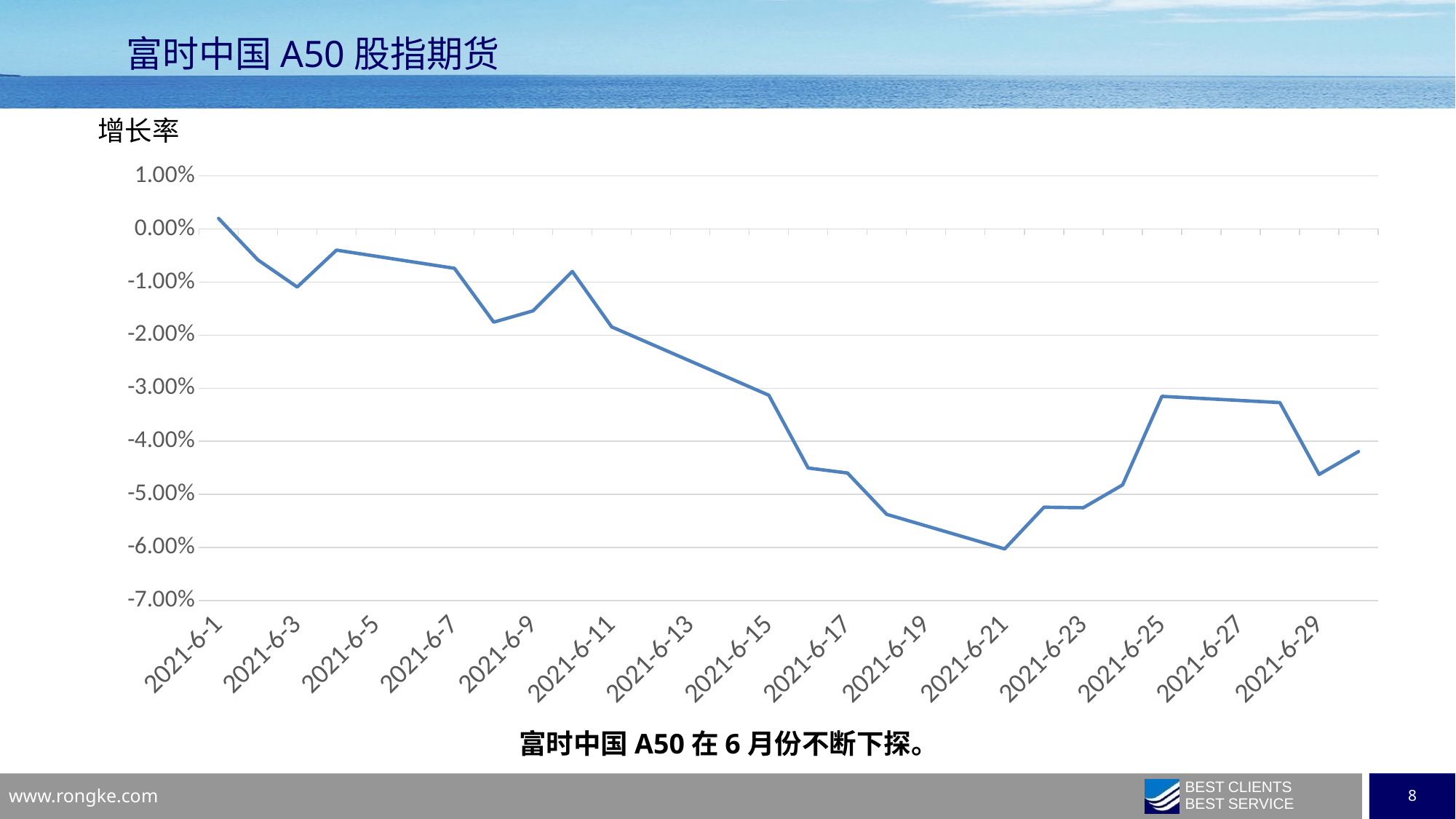
Is the value for 2021-6-21 greater or less than -5.00%? less Is the value for 2021-6-25 greater or less than -4.00%? greater What kind of chart is shown on the slide? line chart On which date does the line reach its lowest value? 2021-6-21 Is the value for 2021-6-17 greater or less than -4.00%? less What is the title of the slide containing the chart? 富时中国 A50 股指期货 On which date does the line reach its highest value? 2021-6-1 Which date has the larger value, 2021-6-1 or 2021-6-21? 2021-6-1 Overall, does the line rise or fall from 2021-6-1 to 2021-6-21? fall What label is shown on the vertical axis of the chart? 增长率